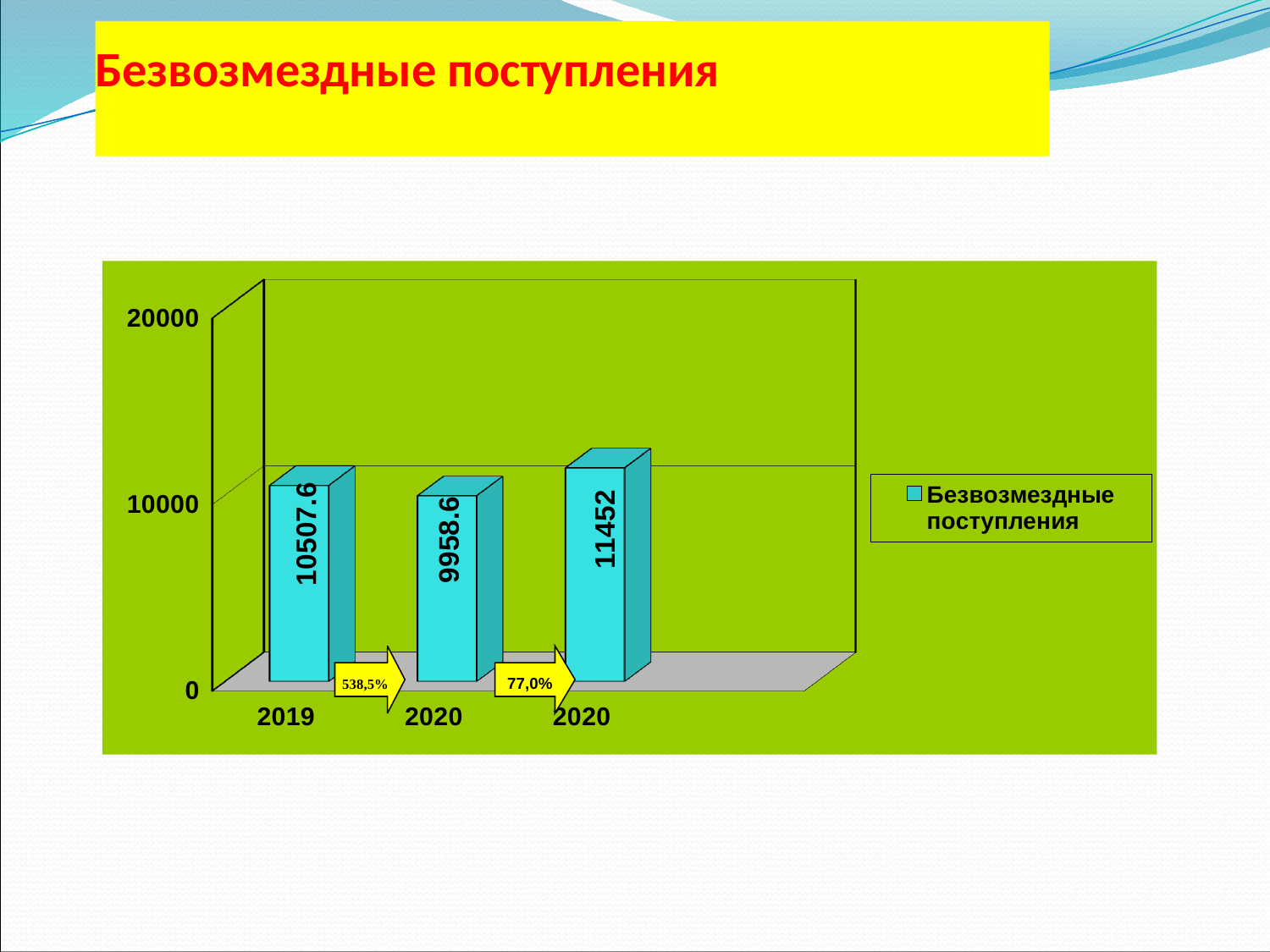
How many series does the legend list? 1 What is the difference between the rightmost bar and the 2019 bar? 944.4 What is the value of the bar for 2019? 10507.6 Which bar has the highest value? The rightmost bar (11452) Which bar has the lowest value? The middle bar (9958.6) What is the difference between the 2019 bar and the middle bar? 549 Which is larger, the 2019 bar or the middle bar? The 2019 bar How many bars are plotted in the chart? 3 Is the value for 2019 greater or less than 10000? greater What is the value of the rightmost bar (the second bar labelled 2020)? 11452 What kind of chart is shown on the slide? Bar chart What is the value of the middle bar (the first bar labelled 2020)? 9958.6